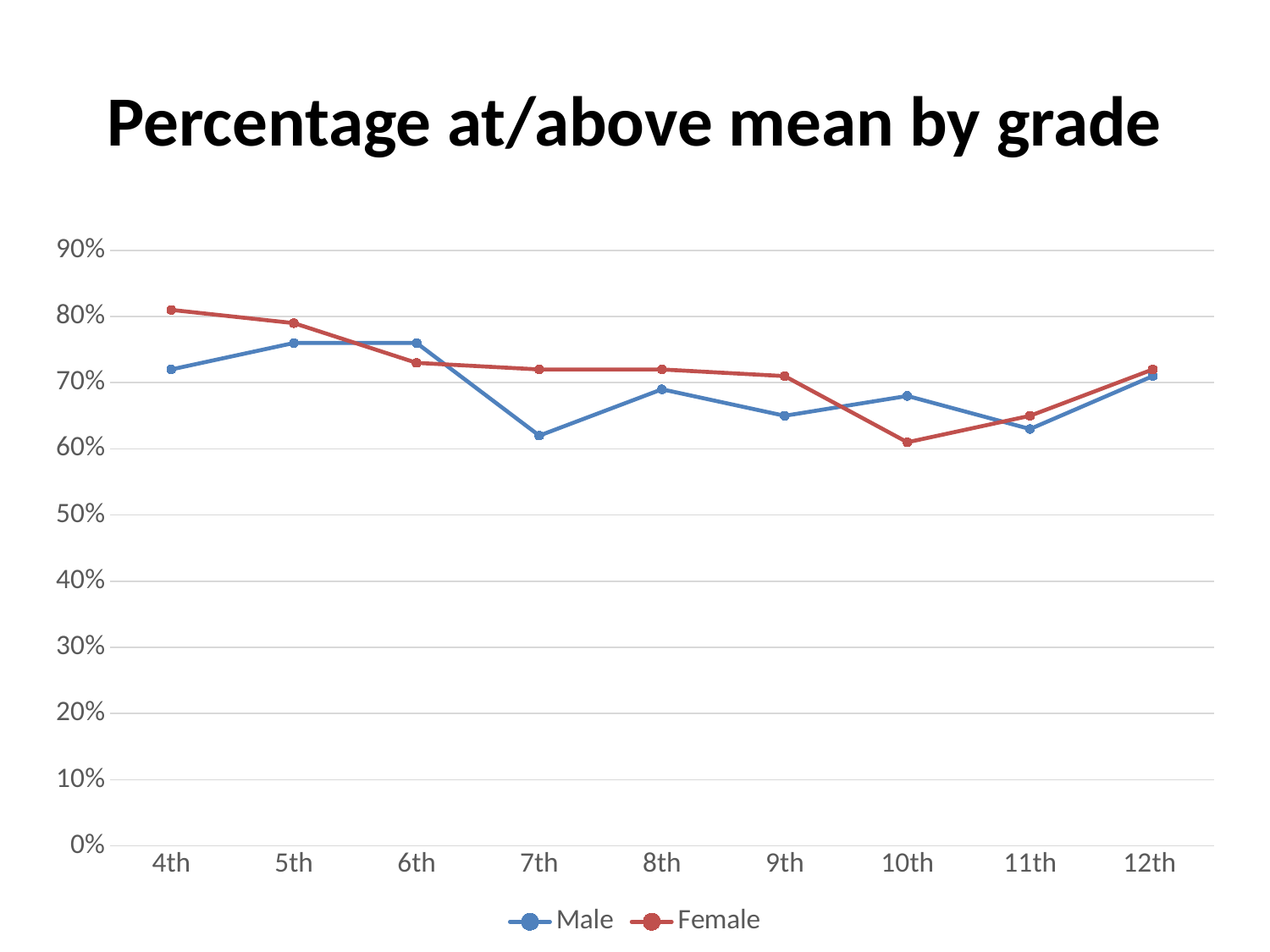
At 10th grade, which series has the higher value, Male or Female? Male At which grade is the Female series lowest? 10th Which series is drawn in red? Female What is the title of the chart? Percentage at/above mean by grade How many series does the legend list? 2 At which grade is the Female series highest? 4th At 4th grade, which series has the higher value, Male or Female? Female What kind of chart is shown on the slide? line chart Is the Male value for 7th grade greater or less than 70%? less Does the Female series generally rise or fall from 4th grade to 10th grade? fall Is the Female value for 4th grade greater or less than 70%? greater How many grade categories are plotted along the x axis? 9